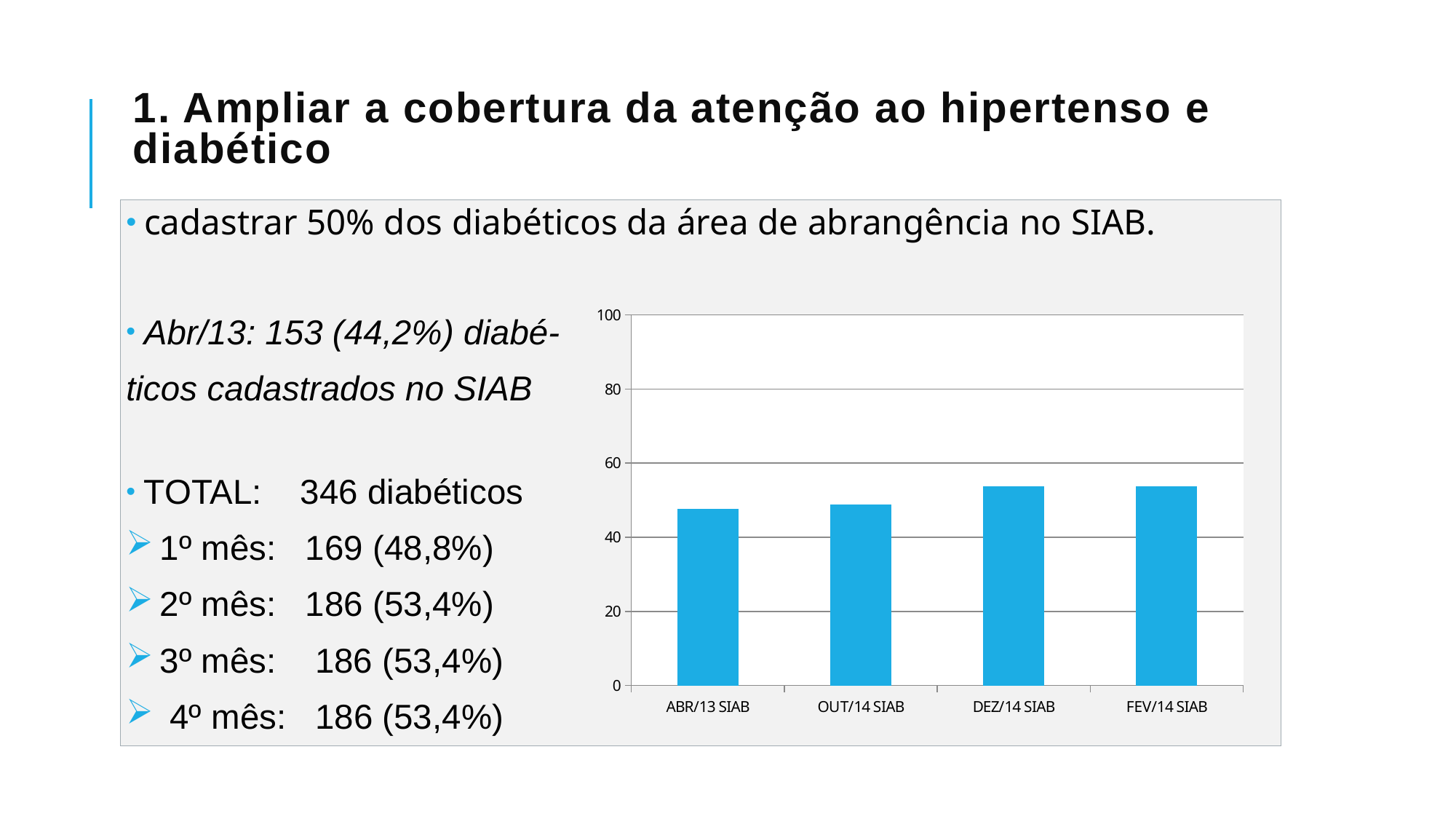
Is the value for ABR/13 SIAB greater or less than 60? less Which is larger, the value for OUT/14 SIAB or the value for FEV/14 SIAB? FEV/14 SIAB How many bars (categories) does the chart show? 4 What is the label of the first category on the x axis? ABR/13 SIAB Is the value for ABR/13 SIAB greater or less than 40? greater Do the values generally rise or fall from left to right along the x axis? rise What kind of chart is shown on the slide? bar chart Is the value for DEZ/14 SIAB greater or less than 60? less What colour are the bars in the chart? blue Which is larger, the value for ABR/13 SIAB or the value for DEZ/14 SIAB? DEZ/14 SIAB